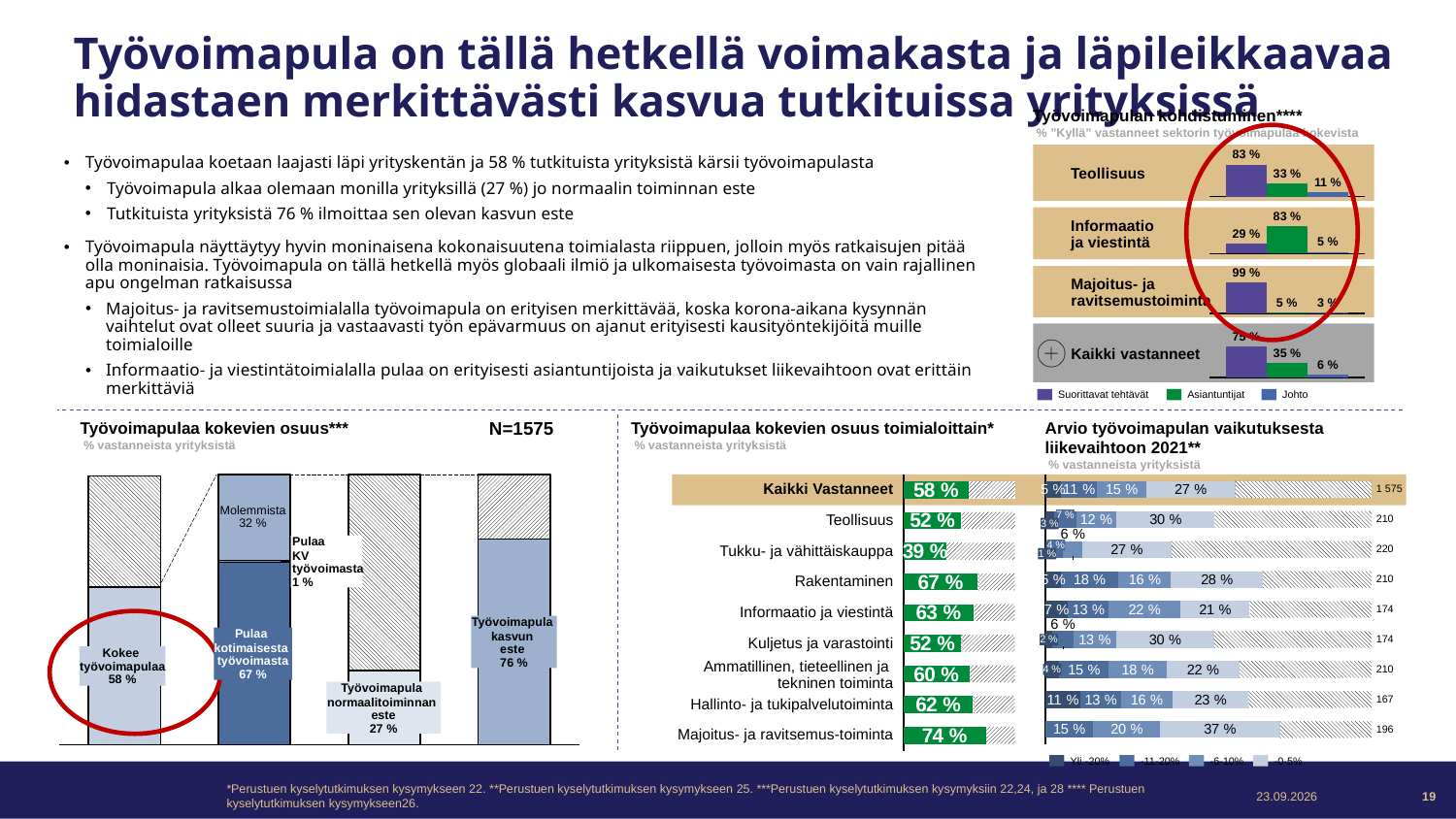
In the chart 'Työvoimapulaa kokevien osuus***', what share of companies report that labour shortage is an obstacle to growth (Työvoimapula kasvun este)? 76 % In the chart 'Työvoimapulan kohdistuminen****', which is larger for Informaatio ja viestintä: Asiantuntijat or Johto? Asiantuntijat In the chart 'Työvoimapulan kohdistuminen****', what is the value for Suorittavat tehtävät in Majoitus- ja ravitsemustoiminta? 99 % In the chart 'Työvoimapulaa kokevien osuus toimialoittain*', which industry has the lowest share? Tukku- ja vähittäiskauppa In the chart 'Työvoimapulaa kokevien osuus toimialoittain*', which industry has the highest share? Majoitus- ja ravitsemus-toiminta In the chart 'Työvoimapulaa kokevien osuus***', what is the value for Pulaa kotimaisesta työvoimasta? 67 % In the chart 'Työvoimapulan kohdistuminen****', what is the value for Asiantuntijat in Teollisuus? 33 % In the chart 'Työvoimapulaa kokevien osuus toimialoittain*', what is the difference between Rakentaminen and Teollisuus? 15 % What type of chart is 'Työvoimapulaa kokevien osuus toimialoittain*'? Bar chart In the chart 'Työvoimapulaa kokevien osuus toimialoittain*', what is the value for Majoitus- ja ravitsemus-toiminta? 74 % In the chart 'Työvoimapulan kohdistuminen****', how many series does the legend list? 3 In the chart 'Työvoimapulaa kokevien osuus toimialoittain*', how many industry categories are shown (including Kaikki Vastanneet)? 9